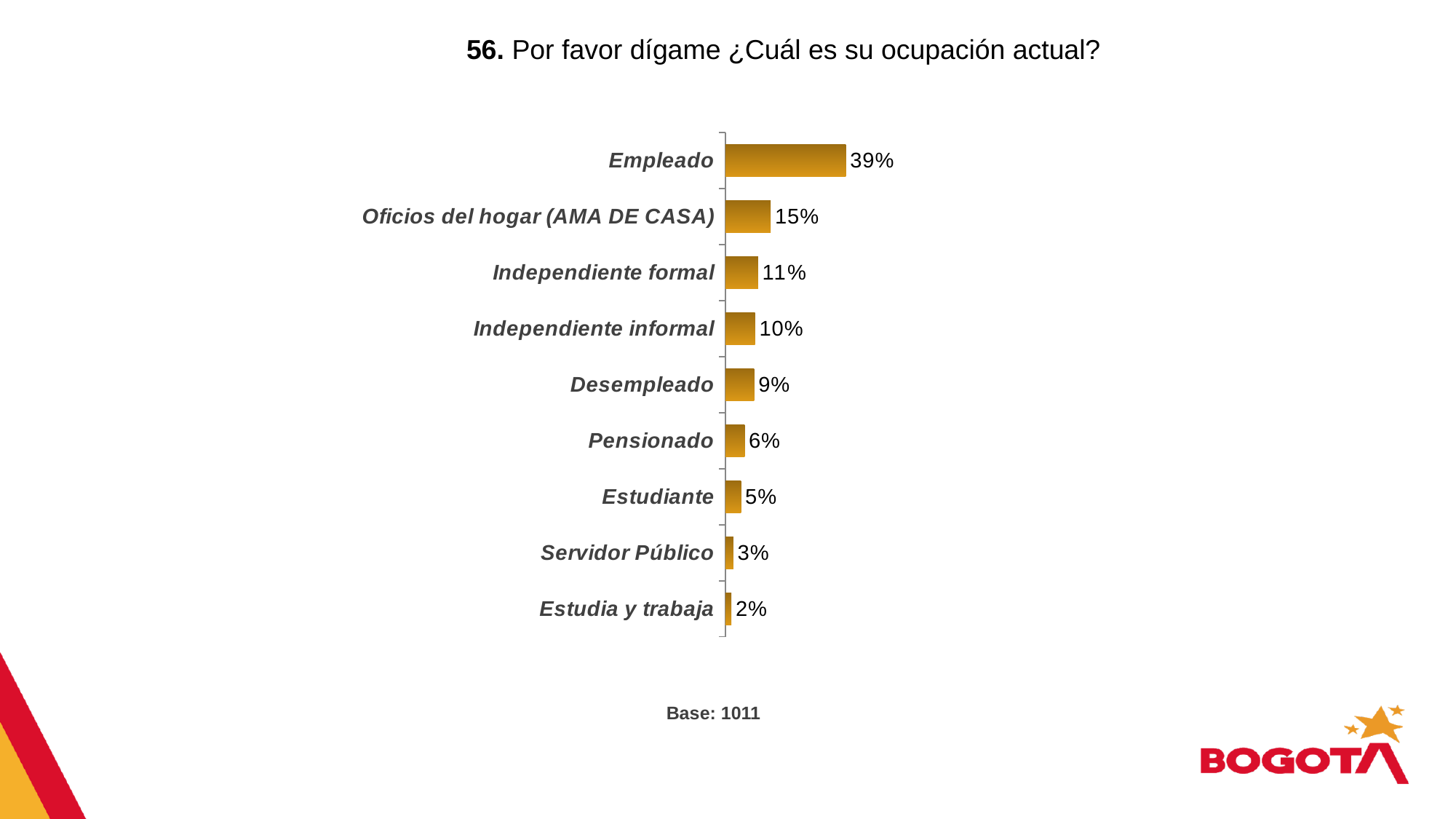
What is the value for Servidor Público? 3% What is the difference between the values for Empleado and Oficios del hogar (AMA DE CASA)? 24% Which is larger, the value for Independiente informal or the value for Estudiante? Independiente informal What is the difference between the values for Independiente formal and Desempleado? 2% Which occupation has the highest value? Empleado What is the value for Pensionado? 6% What is the value for Empleado? 39% How many occupation categories are shown in the chart? 9 Which occupation has the lowest value? Estudia y trabaja What is the base (number of respondents) shown below the chart? 1011 What is the value for Oficios del hogar (AMA DE CASA)? 15% What kind of chart is shown on the slide? Bar chart